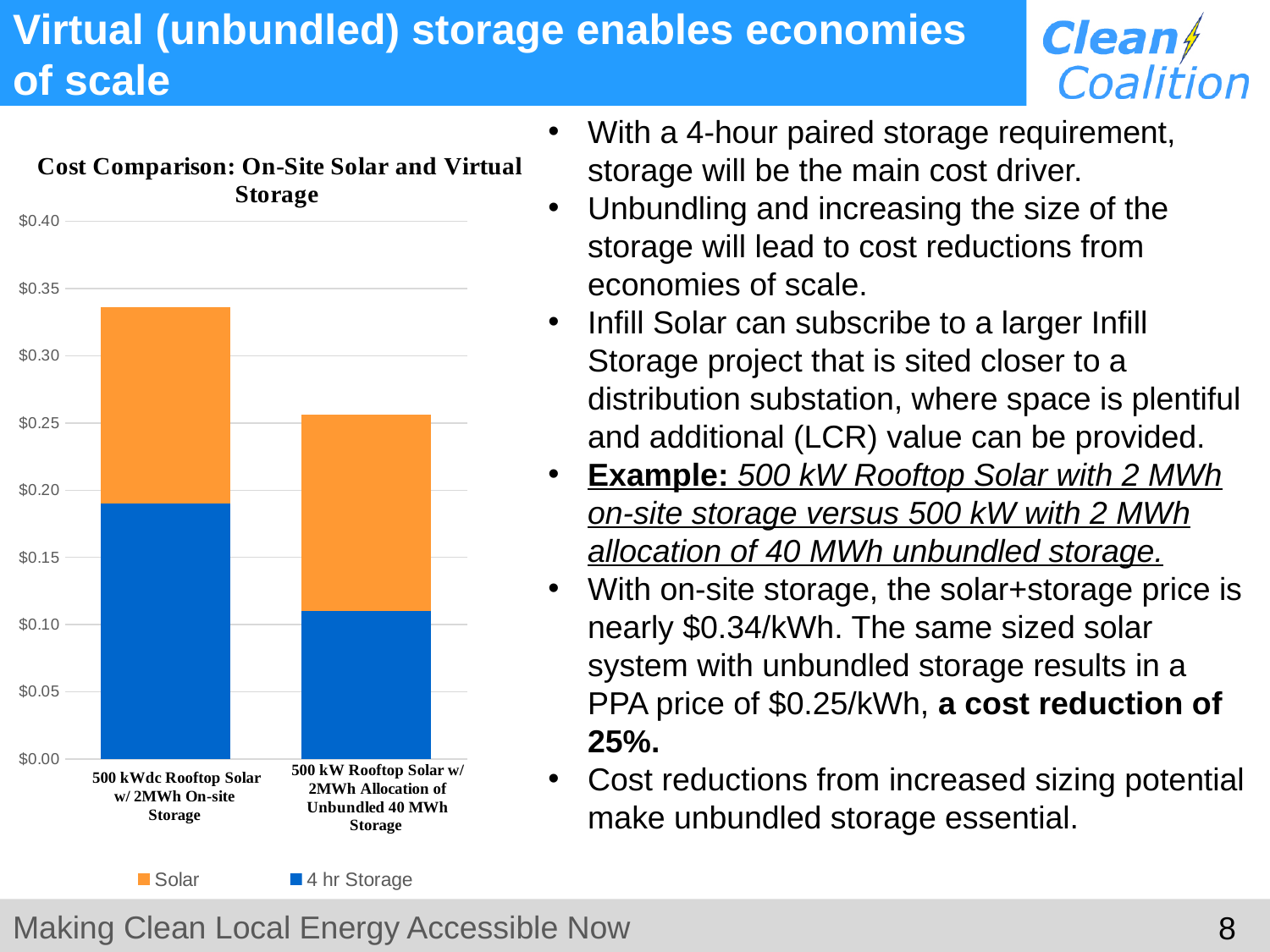
Is the 4 hr Storage segment for 500 kWdc Rooftop Solar w/ 2MWh On-site Storage greater or less than $0.15? greater How many series does the chart legend list? 2 Which category has the higher total bar? 500 kWdc Rooftop Solar w/ 2MWh On-site Storage What kind of chart is shown on the slide? Stacked bar chart Is the total bar for 500 kW Rooftop Solar w/ 2MWh Allocation of Unbundled 40 MWh Storage greater or less than $0.30? less Which series is shown in orange in the chart? Solar Is the 4 hr Storage segment for 500 kW Rooftop Solar w/ 2MWh Allocation of Unbundled 40 MWh Storage greater or less than $0.15? less How many bars (categories) does the chart show? 2 What is the title of the chart? Cost Comparison: On-Site Solar and Virtual Storage Which category has the larger 4 hr Storage segment? 500 kWdc Rooftop Solar w/ 2MWh On-site Storage Which category has the lower total bar? 500 kW Rooftop Solar w/ 2MWh Allocation of Unbundled 40 MWh Storage